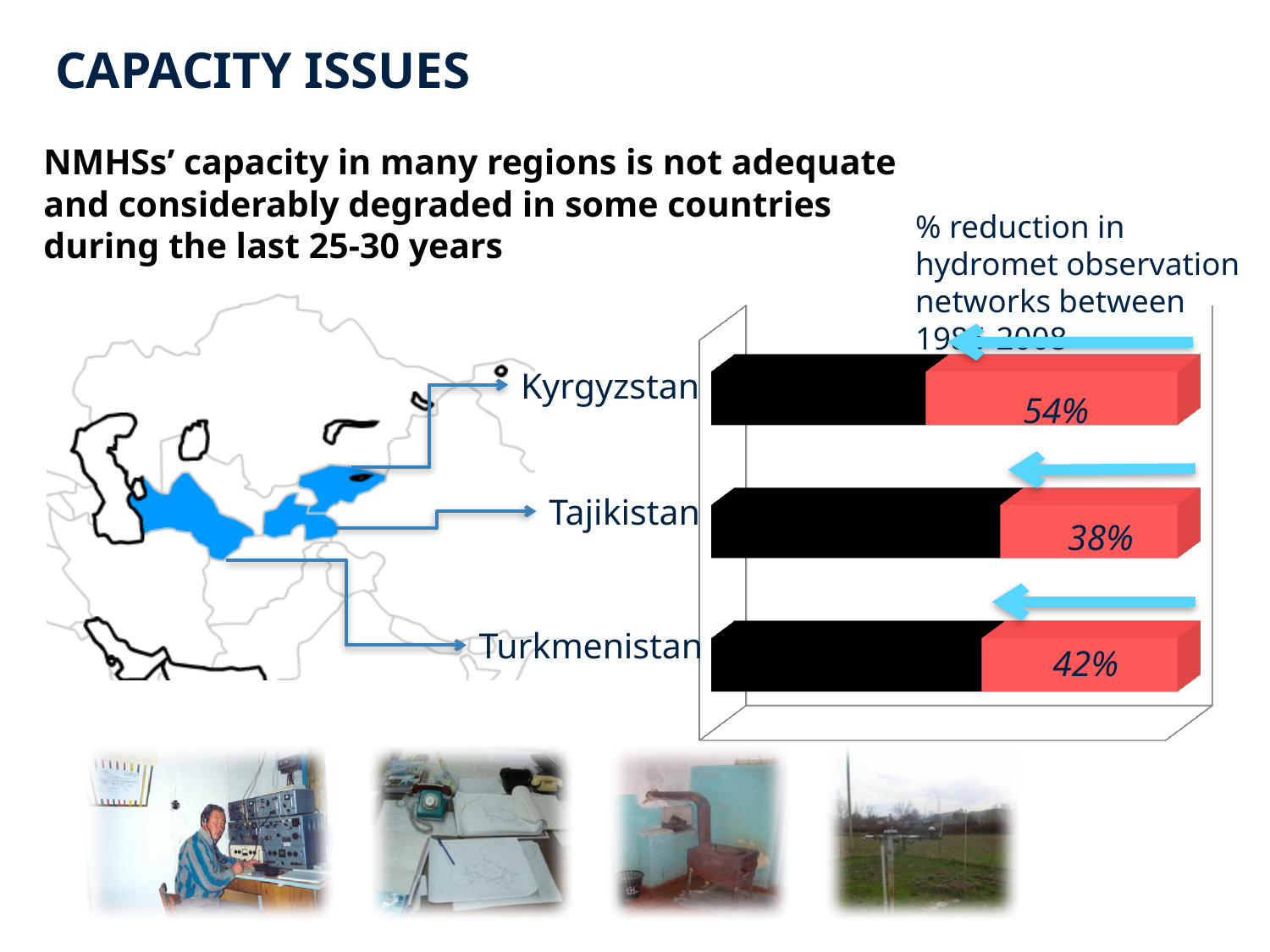
Which country has the highest percentage reduction in the chart? Kyrgyzstan What kind of chart is shown on the slide? bar chart What is the percentage reduction shown for Tajikistan? 38% How many countries are shown in the bar chart? 3 What colour are the bar segments that carry the percentage labels? red Which has the larger percentage reduction, Kyrgyzstan or Turkmenistan? Kyrgyzstan Which country has the lowest percentage reduction in the chart? Tajikistan What is the difference in percentage points between Turkmenistan's and Tajikistan's values? 4 What is the percentage reduction shown for Kyrgyzstan? 54% Which has the larger percentage reduction, Turkmenistan or Tajikistan? Turkmenistan What is the percentage reduction shown for Turkmenistan? 42% What is the difference in percentage points between Kyrgyzstan's and Tajikistan's values? 16